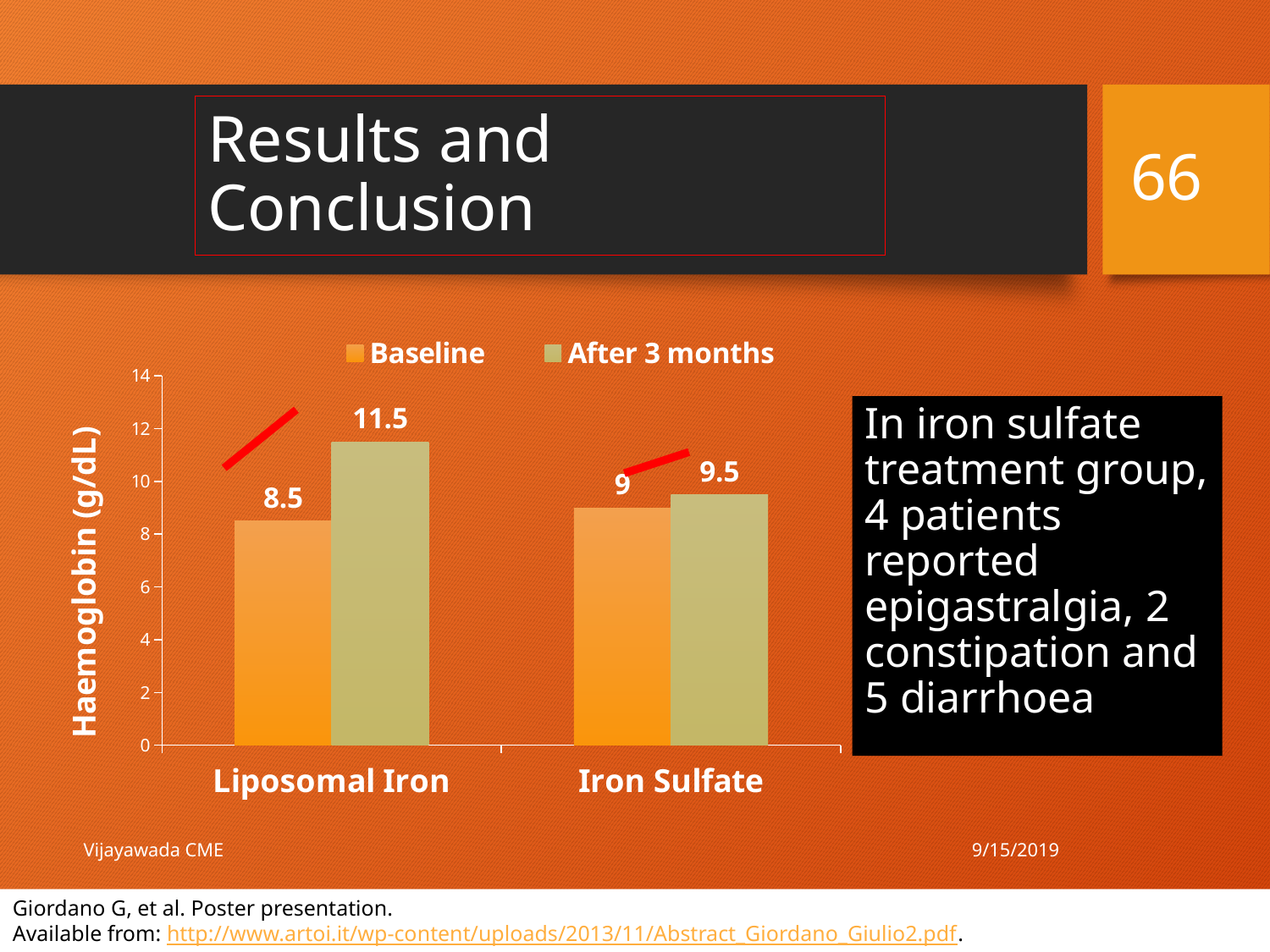
What is the After 3 months haemoglobin value for Liposomal Iron? 11.5 What is the After 3 months haemoglobin value for Iron Sulfate? 9.5 What is the label of the y axis? Haemoglobin (g/dL) What is the difference between the After 3 months and Baseline values for Liposomal Iron? 3 Which bar in the chart has the lowest value? Liposomal Iron, Baseline What is the difference between the After 3 months values for Liposomal Iron and Iron Sulfate? 2 What is the Baseline haemoglobin value for Iron Sulfate? 9 What kind of chart is shown on the slide? Bar chart How many series does the legend list? 2 What is the Baseline haemoglobin value for Liposomal Iron? 8.5 Which bar in the chart has the highest value? Liposomal Iron, After 3 months Which is larger: the Baseline value for Liposomal Iron or the Baseline value for Iron Sulfate? Iron Sulfate